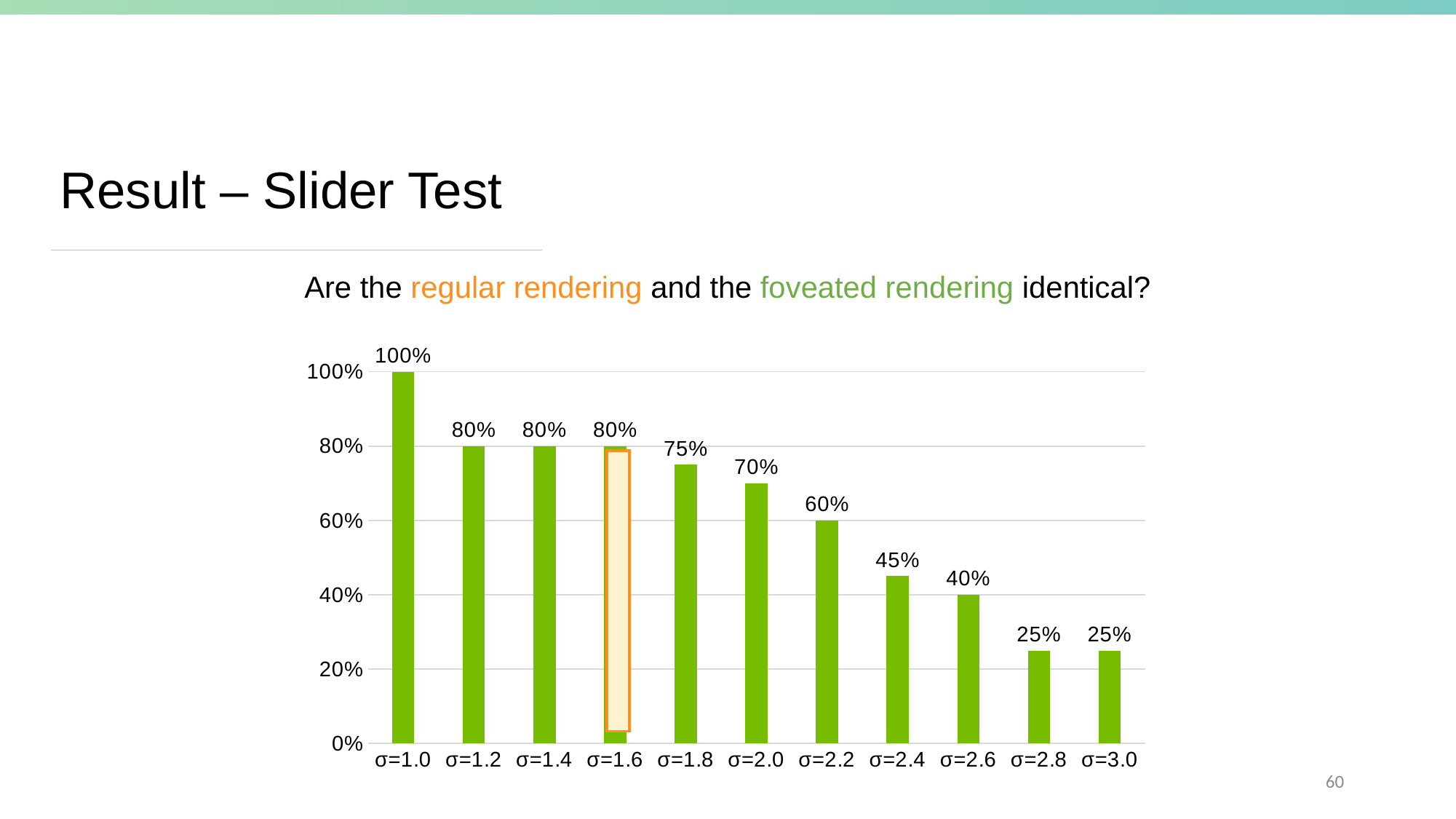
What kind of chart is shown on the slide? bar chart Do the values generally rise or fall as σ increases along the x axis? fall Which bar is highlighted with an orange outline? σ=1.6 What is the difference between the values for σ=1.8 and σ=2.6? 35% How many categories are shown on the x axis? 11 What is the value for σ=1.0? 100% Which category has the highest value? σ=1.0 What is the value for σ=3.0? 25% What is the value for σ=2.4? 45% What is the difference between the values for σ=1.0 and σ=2.0? 30% What is the value for σ=2.2? 60% Which is larger, the value for σ=2.0 or the value for σ=2.4? σ=2.0